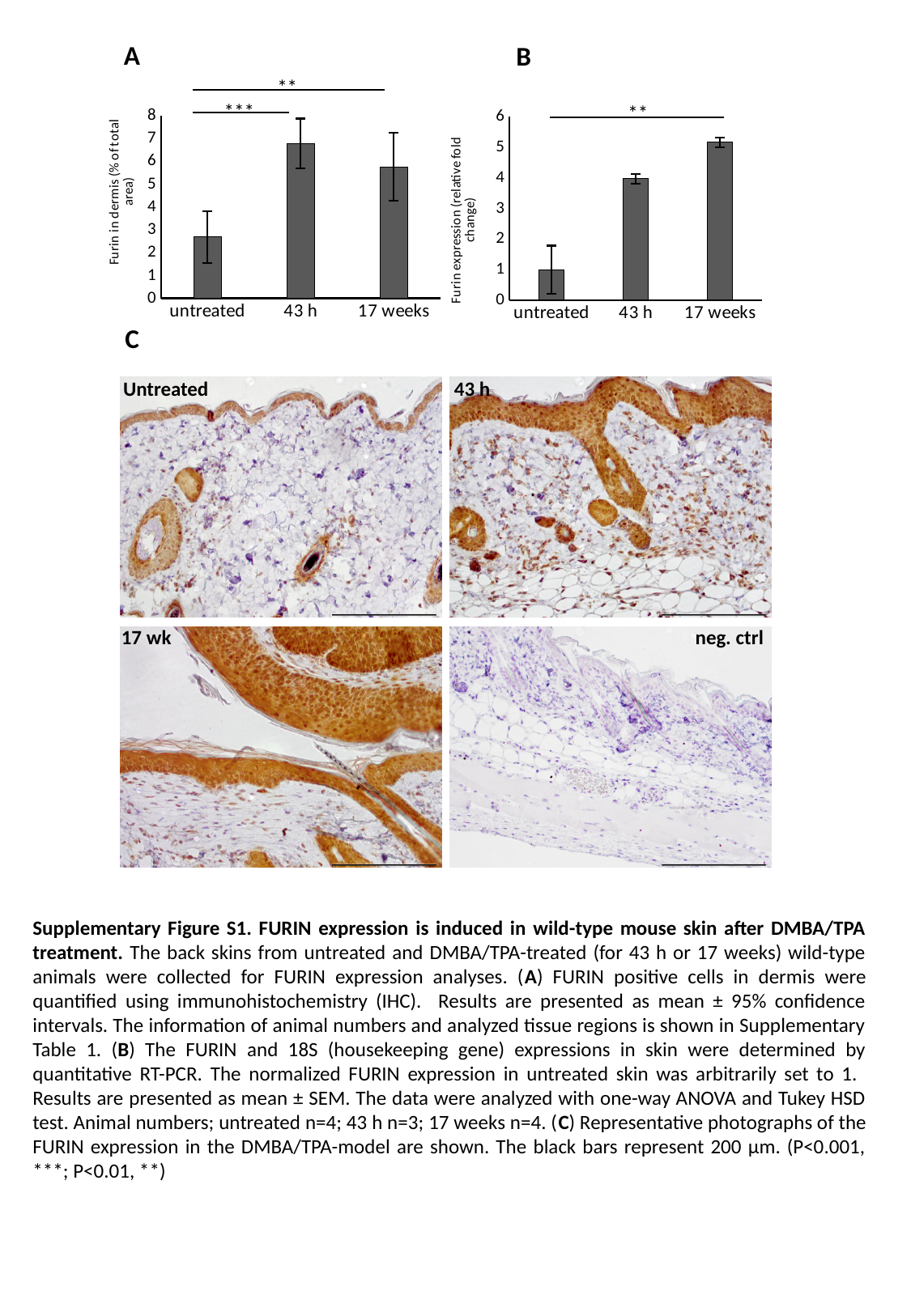
In chart B (Furin expression), which category has the highest bar? 17 weeks In chart A (Furin in dermis), is the value for 43 h greater or less than 6? greater In chart B, what is the label of the y axis? Furin expression (relative fold change) In chart A (Furin in dermis), which category has the lowest bar? untreated In chart B (Furin expression), do the values rise or fall from untreated to 17 weeks along the x axis? rise In chart A (Furin in dermis), is the value for untreated greater or less than 4? less In chart A (Furin in dermis), what kind of chart is shown? bar chart In chart B (Furin expression), is the value for 17 weeks greater or less than 5? greater In chart B (Furin expression), which category has the lowest bar? untreated In chart A (Furin in dermis), how many categories are shown on the x axis? 3 In chart A (Furin in dermis), which category has the highest bar? 43 h